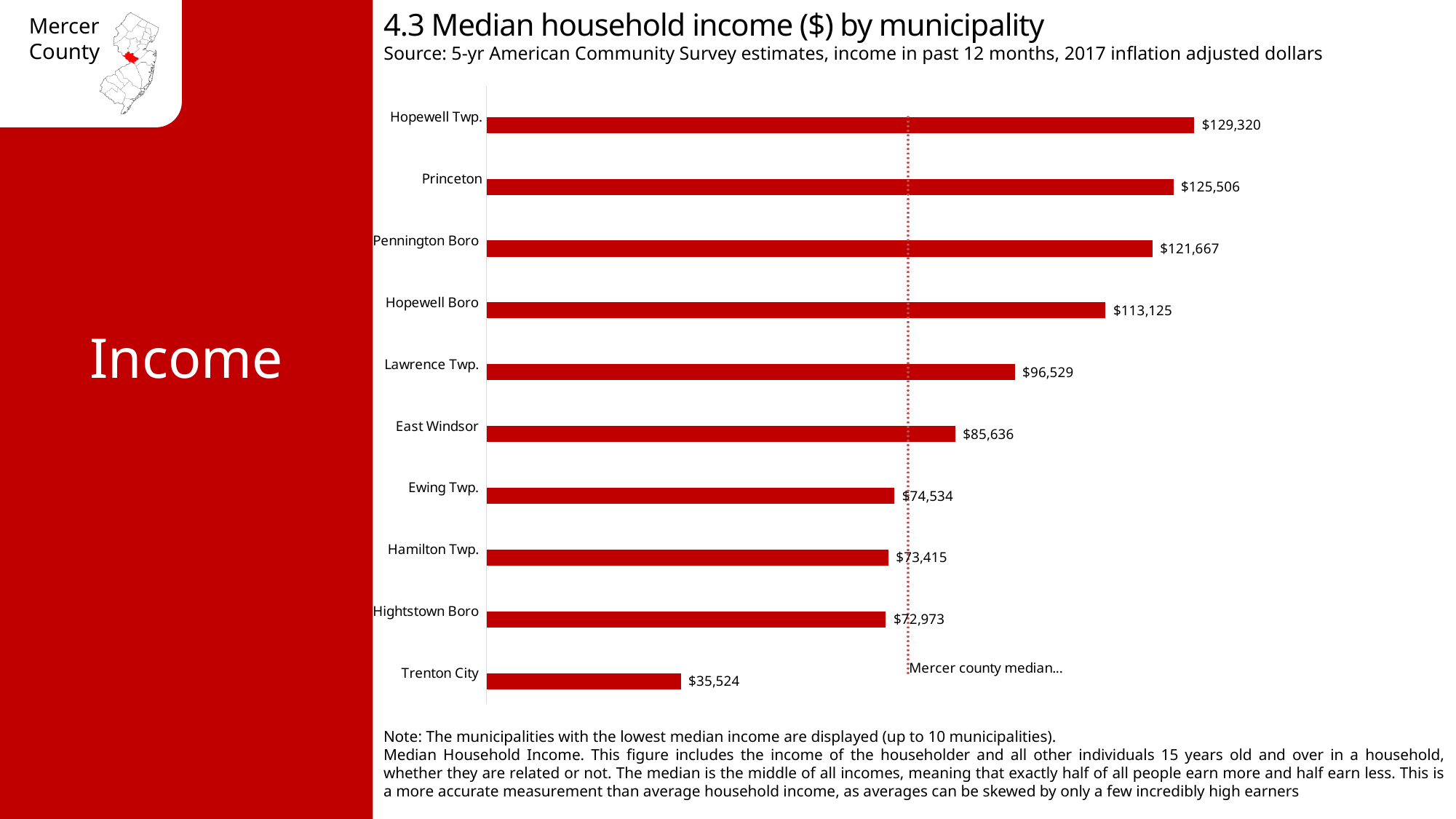
What is the median household income for Lawrence Twp.? $96,529 Which has a higher median household income, Pennington Boro or Hopewell Boro? Pennington Boro How many municipalities are shown in the chart? 10 What is the difference in median household income between Hopewell Boro and Trenton City? $77,601 What is the median household income for Trenton City? $35,524 What does the dotted vertical line on the chart represent? Mercer county median What is the median household income for Princeton? $125,506 Which municipality has the highest median household income? Hopewell Twp. What type of chart is used to show median household income by municipality? Bar chart What is the difference in median household income between Hopewell Twp. and Princeton? $3,814 Which has a higher median household income, East Windsor or Ewing Twp.? East Windsor Which municipality has the lowest median household income? Trenton City